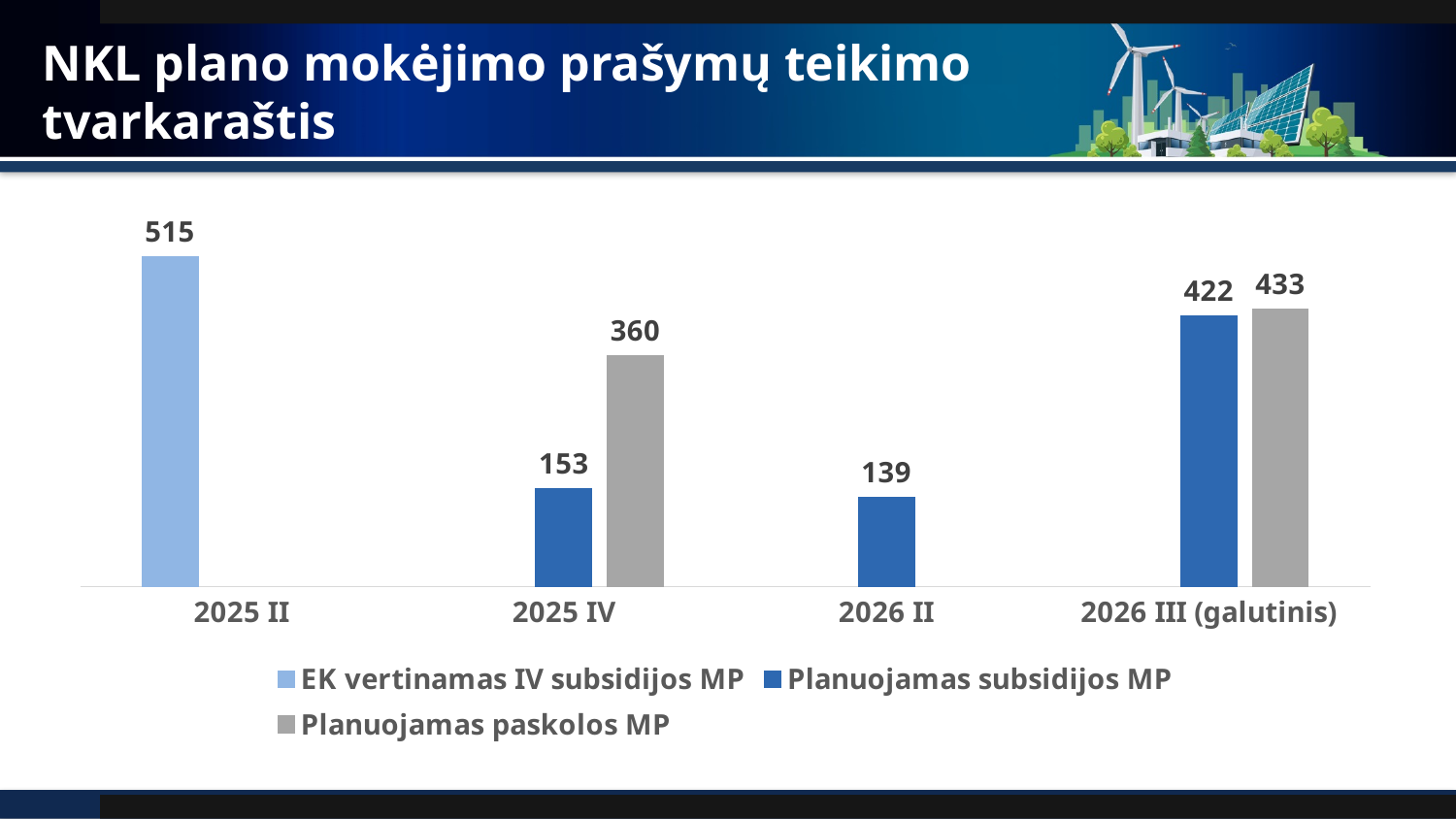
What is the value of Planuojamas subsidijos MP for 2026 II? 139 What is the value of Planuojamas subsidijos MP for 2025 IV? 153 Which is larger: Planuojamas subsidijos MP for 2025 IV or Planuojamas paskolos MP for 2025 IV? Planuojamas paskolos MP Which category has the lowest Planuojamas subsidijos MP value? 2026 II Which category has the highest Planuojamas subsidijos MP value? 2026 III (galutinis) What is the difference between Planuojamas paskolos MP for 2026 III (galutinis) and for 2025 IV? 73 What is the title of the slide containing the chart? NKL plano mokėjimo prašymų teikimo tvarkaraštis What is the value of EK vertinamas IV subsidijos MP for 2025 II? 515 How many series does the legend list? 3 How many categories are shown on the x axis? 4 What kind of chart is shown on the slide? Bar chart What is the value of Planuojamas paskolos MP for 2026 III (galutinis)? 433